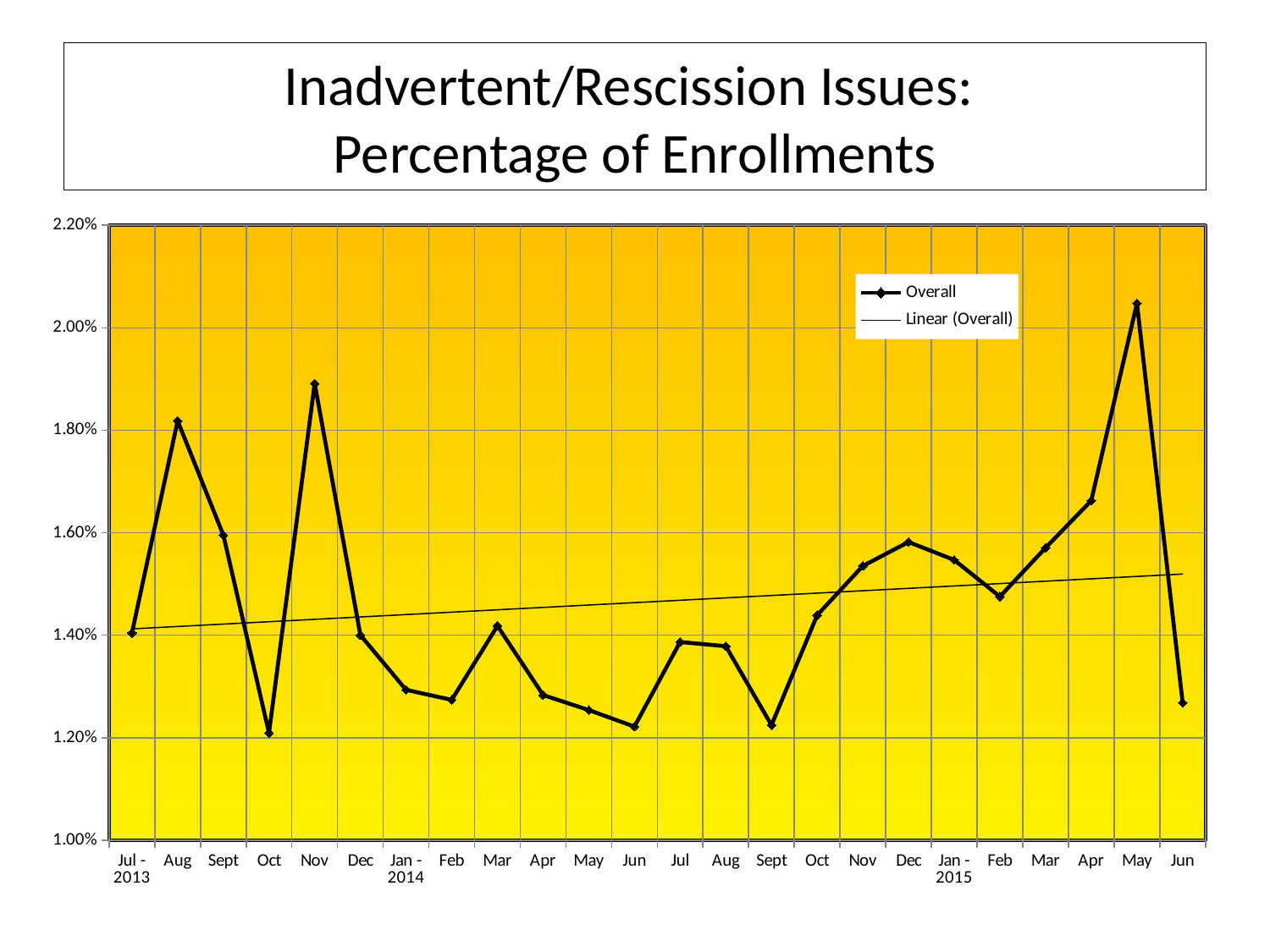
How many entries does the legend list? 2 Does the Linear (Overall) trendline rise or fall from left to right? rise Which month has the highest Overall value? May 2015 Is the Overall value for May 2015 greater or less than 2.00%? greater Is the Overall value for Dec 2014 greater or less than 1.40%? greater How many monthly data points are plotted on the Overall line? 24 What kind of chart is shown on the slide? line chart What is the title of the chart? Inadvertent/Rescission Issues: Percentage of Enrollments Is the Overall value for Jun 2015 greater or less than 1.40%? less Which is higher, the Overall value for Nov 2013 or for May 2015? May 2015